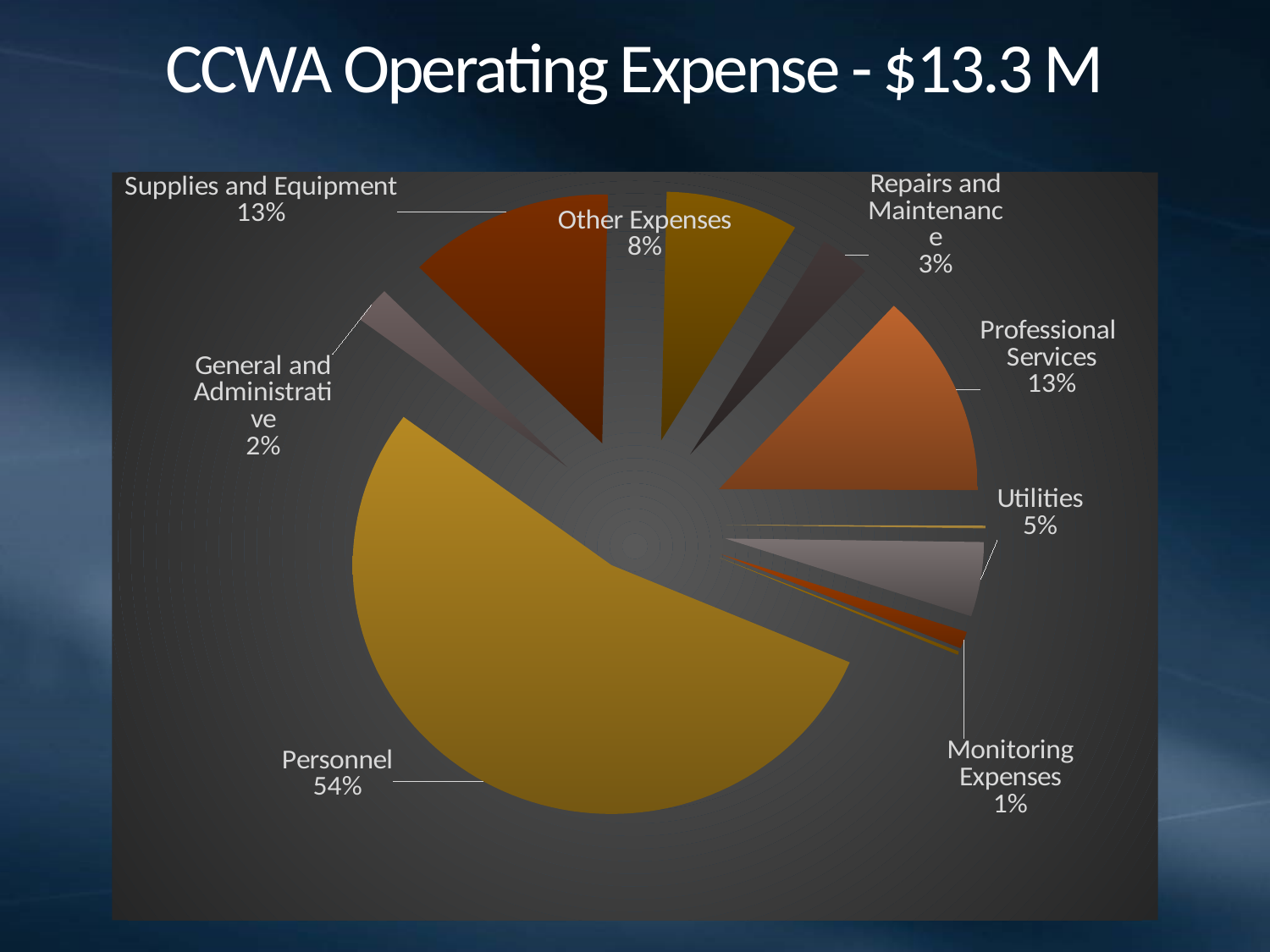
What share of the pie does Personnel represent? 54% Which category has the largest share of the pie? Personnel Which is larger, the share for Utilities or the share for General and Administrative? Utilities What percentage is shown for Other Expenses? 8% What percentage is shown for Utilities? 5% What kind of chart is shown on the slide? pie chart What is the title of the chart on the slide? CCWA Operating Expense - $13.3 M What is the difference in percentage points between Other Expenses and Repairs and Maintenance? 5 What is the difference in percentage points between Personnel and Supplies and Equipment? 41 What percentage is shown for Repairs and Maintenance? 3%